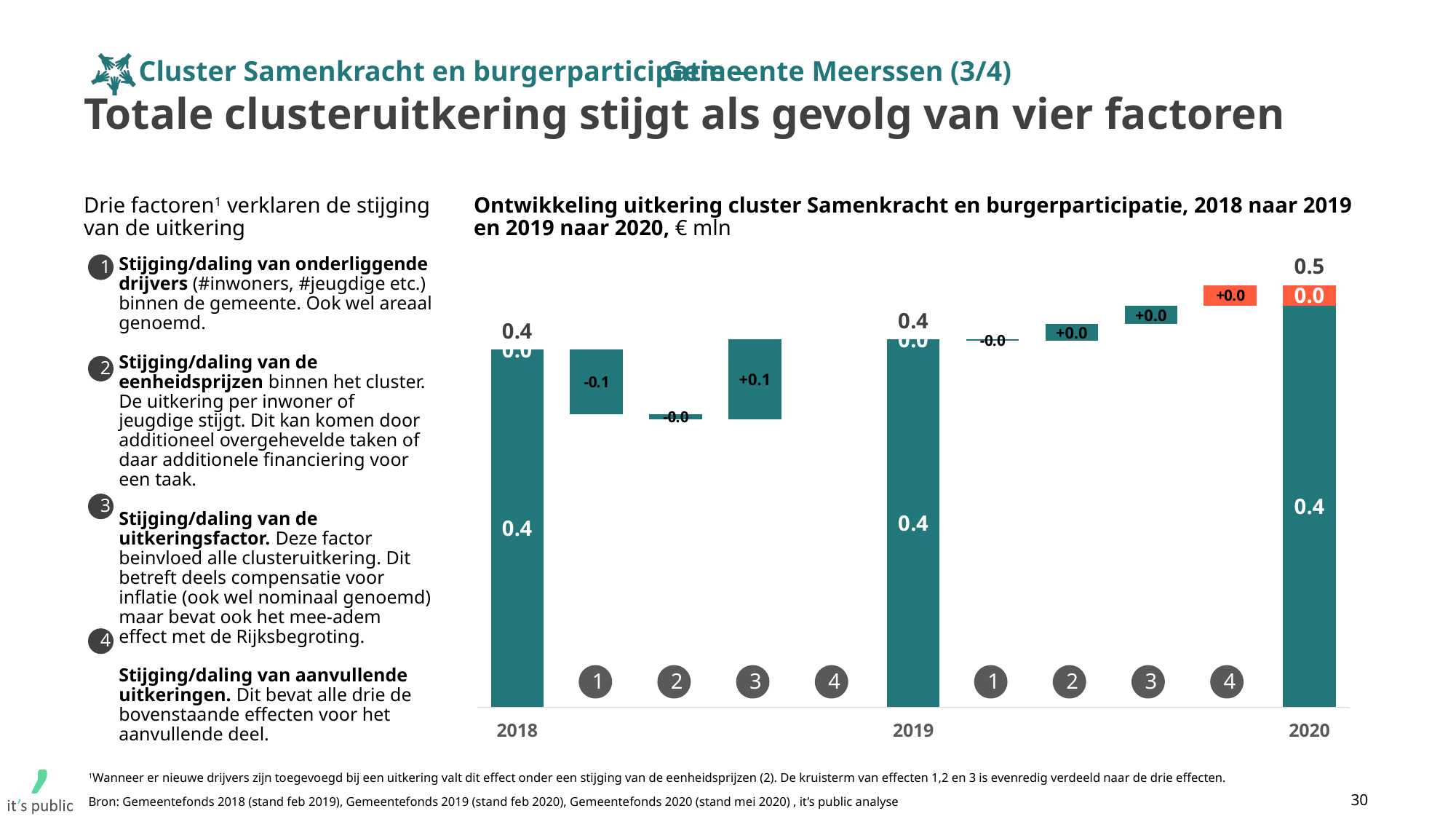
In what unit are the values in the chart expressed? € mln What is the value of factor 3 in the step from 2018 to 2019? +0.1 What is the total value shown for 2018? 0.4 Which is larger, the total for 2018 or the total for 2020? 2020 What is the value of factor 1 in the step from 2018 to 2019? -0.1 Do the year totals rise or fall from 2018 to 2020? rise What is the total value shown for 2019? 0.4 What is the difference between the 2020 total and the 2018 total? 0.1 What is the value of factor 4 in the step from 2019 to 2020? +0.0 What is the total value shown for 2020? 0.5 Which year has the highest total value? 2020 What kind of chart is shown? bar chart (waterfall)